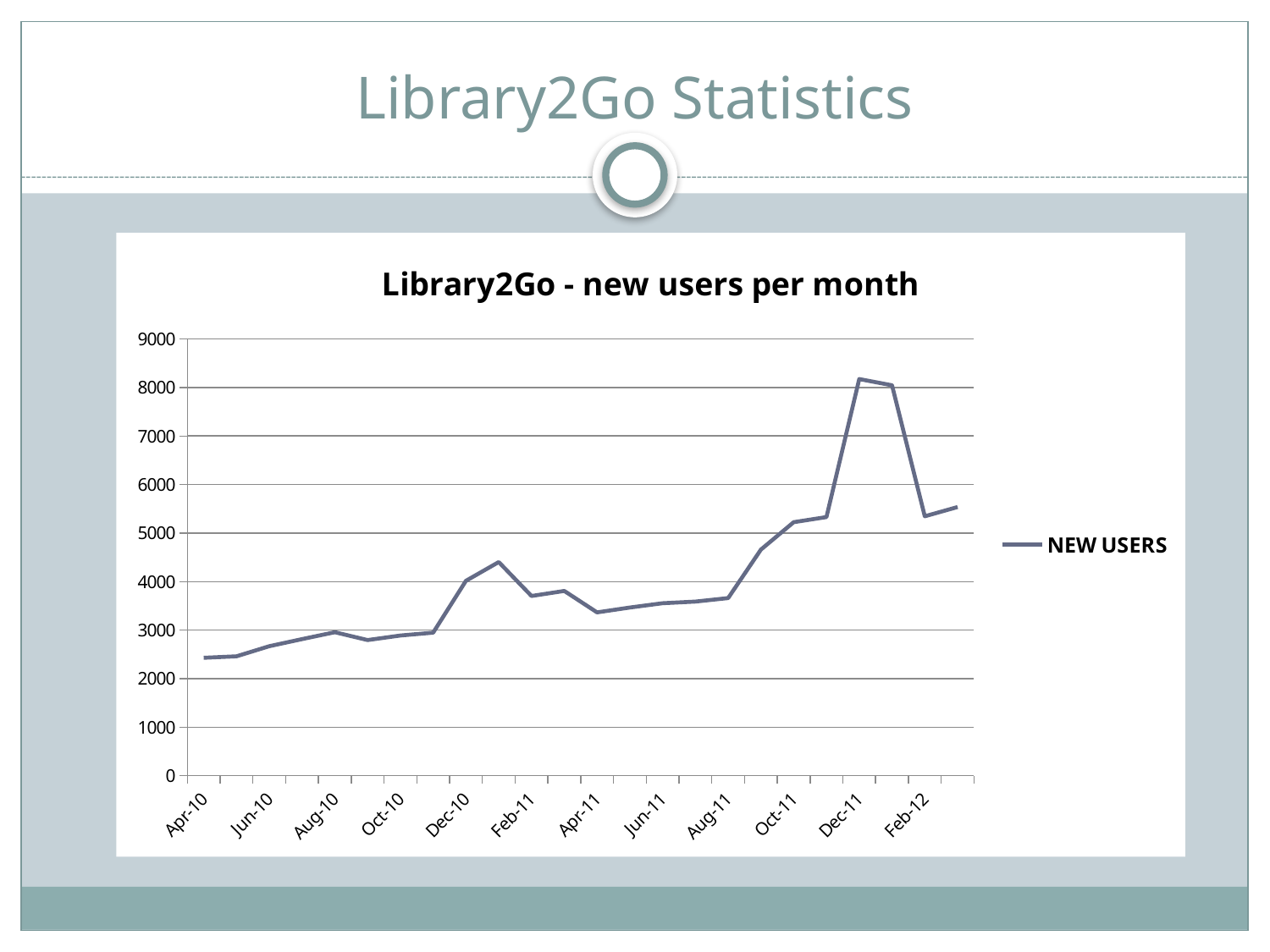
Is the value for Apr-11 greater or less than 4000? less In which labeled month is the number of new users lowest? Apr-10 Which month has more new users, Dec-11 or Feb-12? Dec-11 How many series does the legend list? 1 In which labeled month does the number of new users reach its highest point? Dec-11 Is the value for Dec-11 greater or less than 8000? greater Is the value for Apr-10 greater or less than 3000? less What is the name of the series shown in the legend? NEW USERS What kind of chart is shown on the slide? line chart Overall, do new users per month rise or fall from Apr-10 to Feb-12? rise What is the title of the chart? Library2Go - new users per month